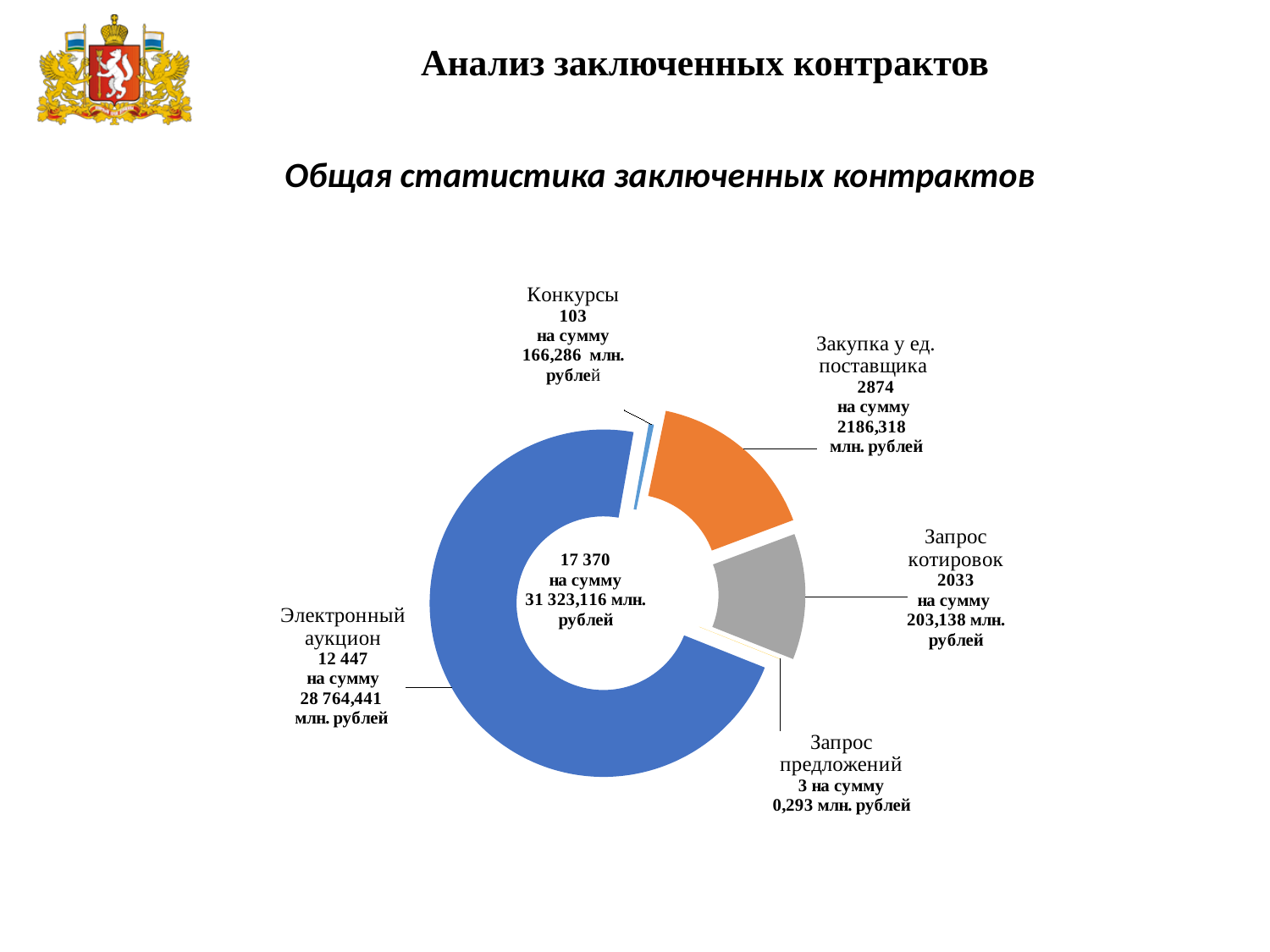
What is the difference in the number of contracts between Закупка у ед. поставщика and Запрос котировок? 841 What is the total amount (на сумму) for Закупка у ед. поставщика? 2186,318 млн. рублей Which category has the largest number of contracts? Электронный аукцион How many contracts were concluded via Запрос котировок? 2033 Which category has the smallest number of contracts? Запрос предложений What is the amount for Конкурсы? 166,286 млн. рублей How many categories (procurement methods) does the chart show? 5 How many contracts were concluded via Электронный аукцион? 12 447 What kind of chart is shown on the slide? Doughnut (pie) chart What is the total amount of all contracts shown in the centre of the chart? 31 323,116 млн. рублей Which has more contracts: Закупка у ед. поставщика or Запрос котировок? Закупка у ед. поставщика What is the total number of contracts shown in the centre of the chart? 17 370